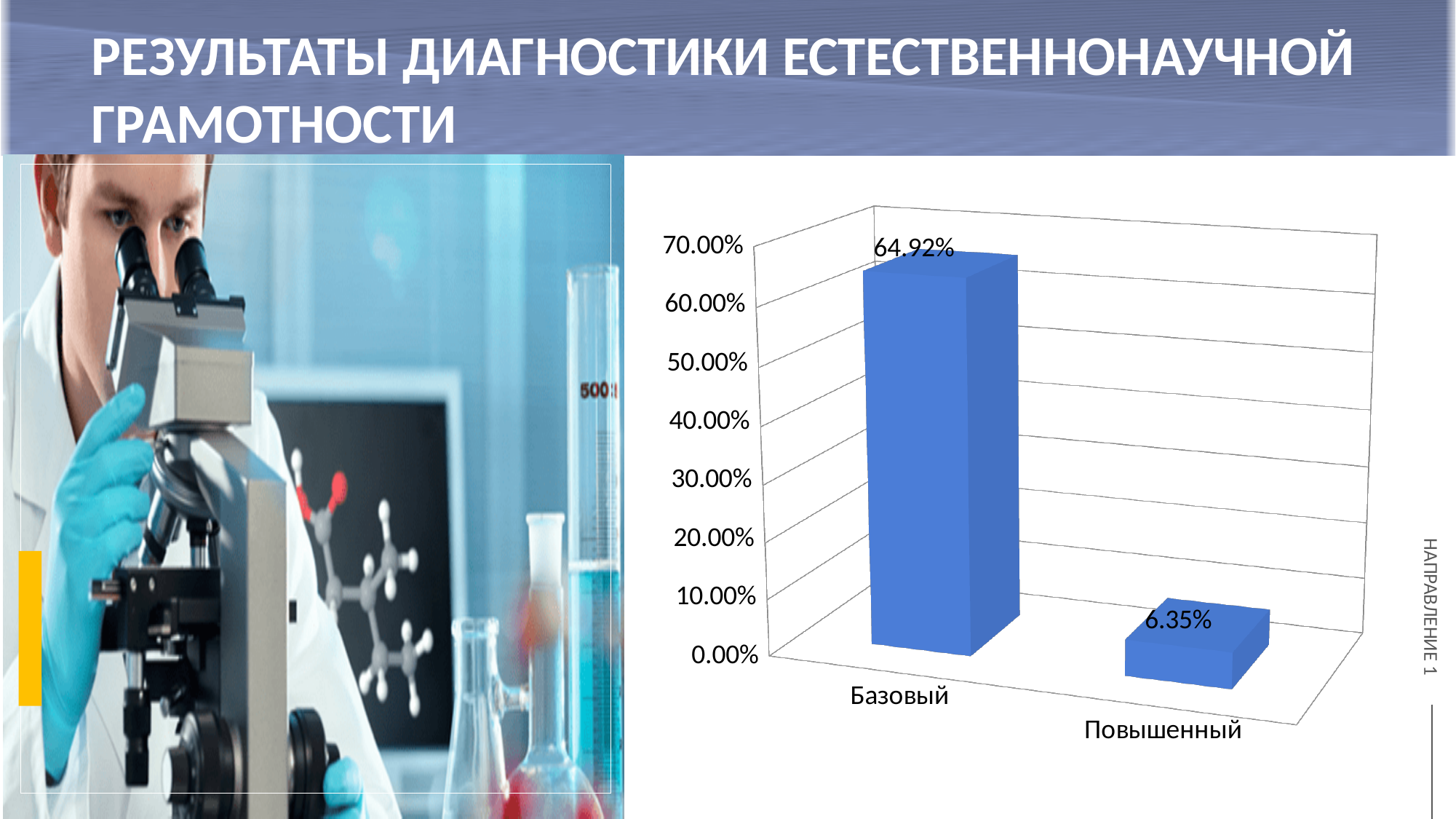
What is the value for Базовый? 64.92% What kind of chart is shown on the slide? bar chart Which category has the highest value? Базовый Which is larger, the value for Базовый or the value for Повышенный? Базовый What is the highest value shown on the vertical axis of the chart? 70.00% How many categories are shown on the chart? 2 What is the value for Повышенный? 6.35% Is the value for Повышенный greater or less than 10.00%? less Is the value for Базовый greater or less than 60.00%? greater What is the difference between the values for Базовый and Повышенный? 58.57% Which category has the lowest value? Повышенный What colour are the bars in the chart? blue